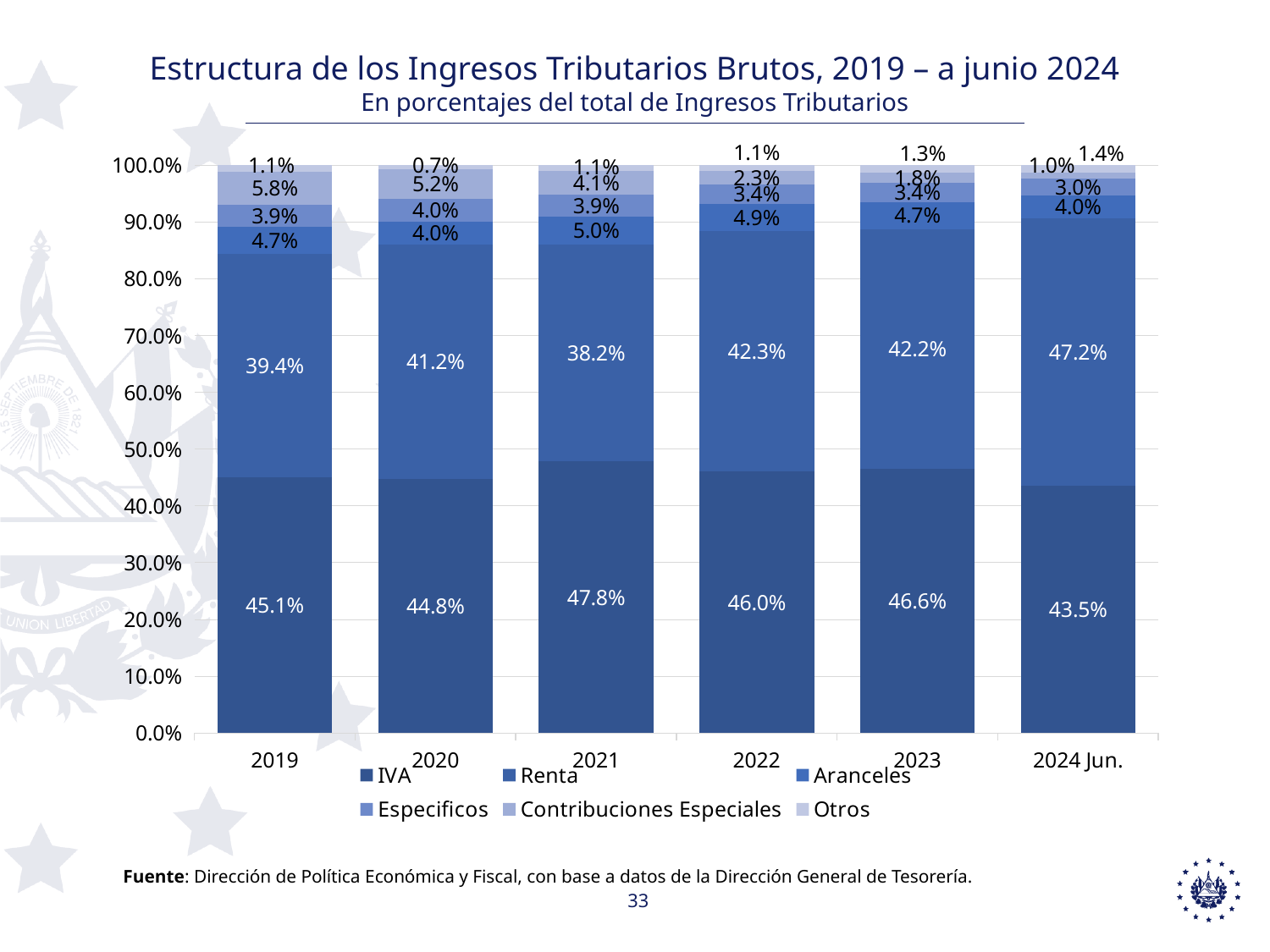
What is the title of the chart? Estructura de los Ingresos Tributarios Brutos, 2019 – a junio 2024 What is the IVA share in 2019? 45.1% In which year is the IVA share lowest? 2024 Jun. In 2024 Jun., which is larger: the IVA share or the Renta share? Renta How many years (categories) are shown along the x axis? 6 By how many percentage points does the Renta share in 2024 Jun. exceed the Renta share in 2019? 7.8 percentage points Does the Contribuciones Especiales share rise or fall from 2019 to 2024 Jun.? Fall How many series does the legend list? 6 What is the Contribuciones Especiales share in 2019? 5.8% In which year is the IVA share highest? 2021 What kind of chart is shown on the slide? Stacked bar chart What is the Renta share in 2024 Jun.? 47.2%